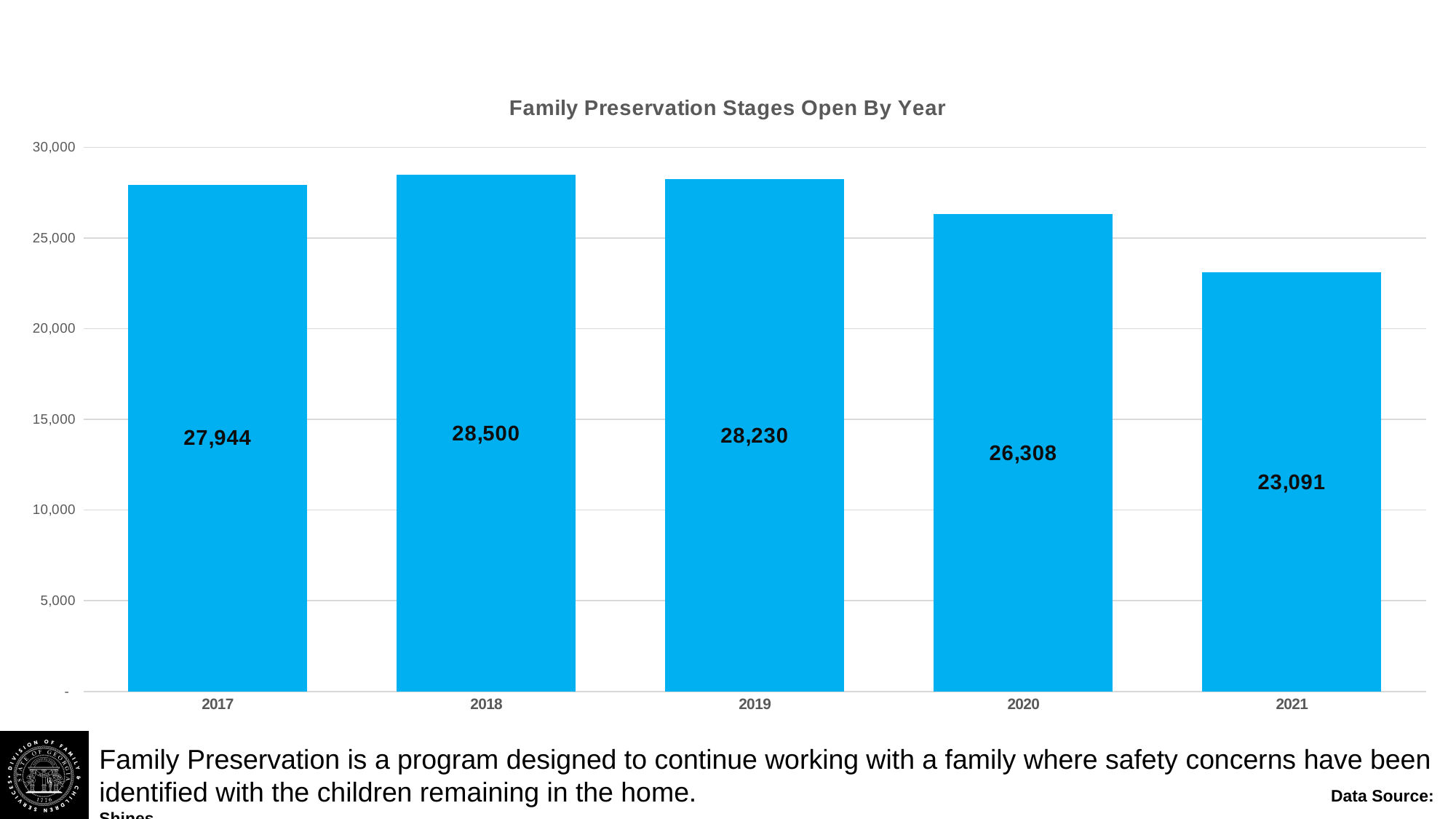
What is the value for 2017? 27,944 Which is larger, the value for 2017 or the value for 2020? 2017 What is the value for 2021? 23,091 How many years are shown on the chart? 5 What is the difference between the values for 2018 and 2021? 5,409 Is the value for 2021 greater or less than 25,000? less What is the value for 2020? 26,308 Which year has the lowest number of Family Preservation stages open? 2021 What kind of chart is shown on the slide? bar chart Which year has the highest number of Family Preservation stages open? 2018 What is the title of the chart? Family Preservation Stages Open By Year What is the difference between the values for 2019 and 2020? 1,922